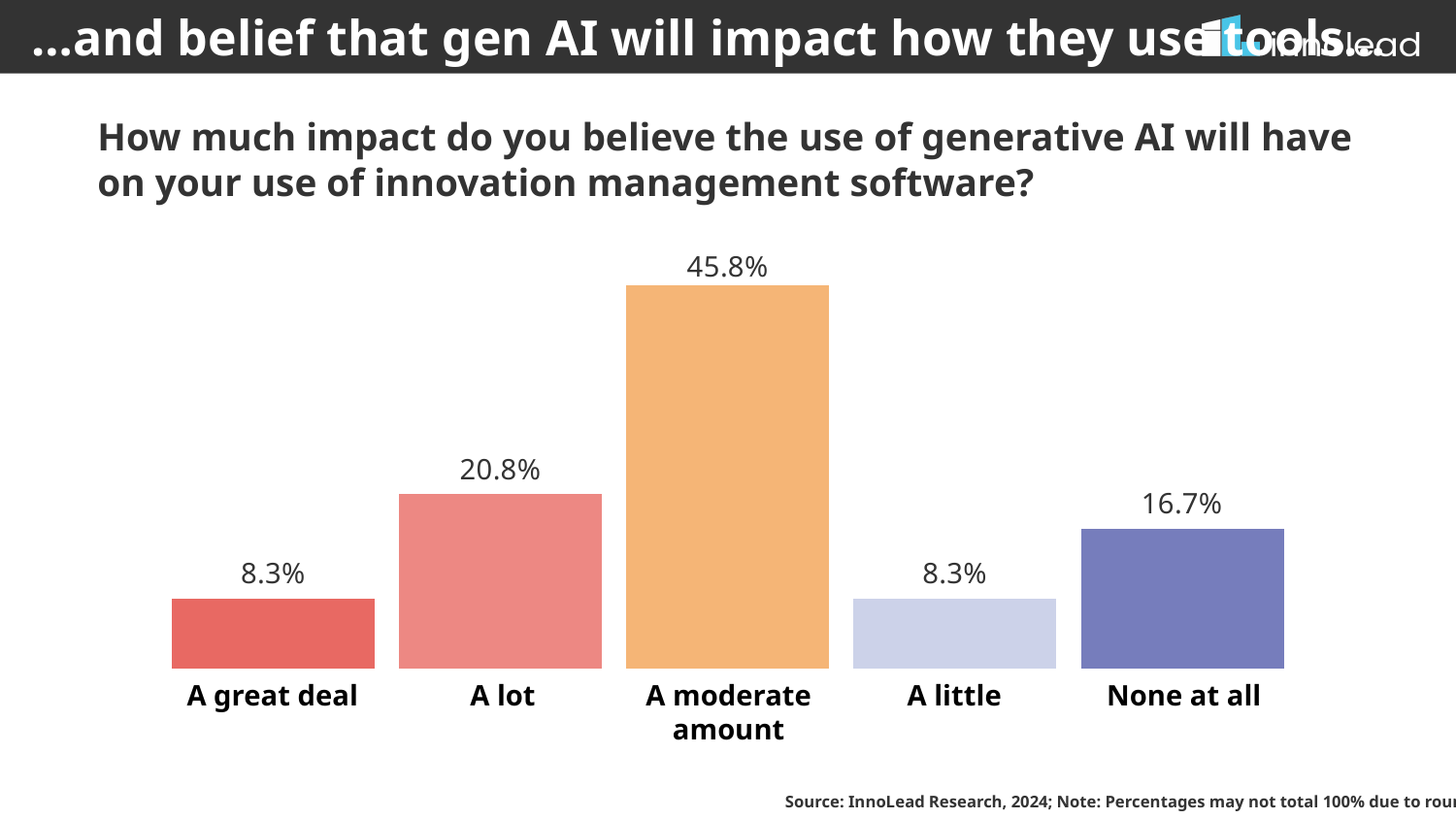
What is the difference between the values for 'None at all' and 'A little'? 8.4 percentage points Which two response categories share the same value of 8.3%? A great deal and A little What is the source cited for the chart data? InnoLead Research, 2024 What is the value shown for 'None at all'? 16.7% What is the difference between the values for 'A moderate amount' and 'A lot'? 25 percentage points What kind of chart is shown on the slide? Bar chart What percentage of respondents said generative AI will have 'A moderate amount' of impact on their use of innovation management software? 45.8% How many response categories are shown on the chart? 5 Which response category has the highest value? A moderate amount What is the value shown for 'A lot'? 20.8% Which is larger, the value for 'A lot' or the value for 'None at all'? A lot What is the value shown for 'A great deal'? 8.3%